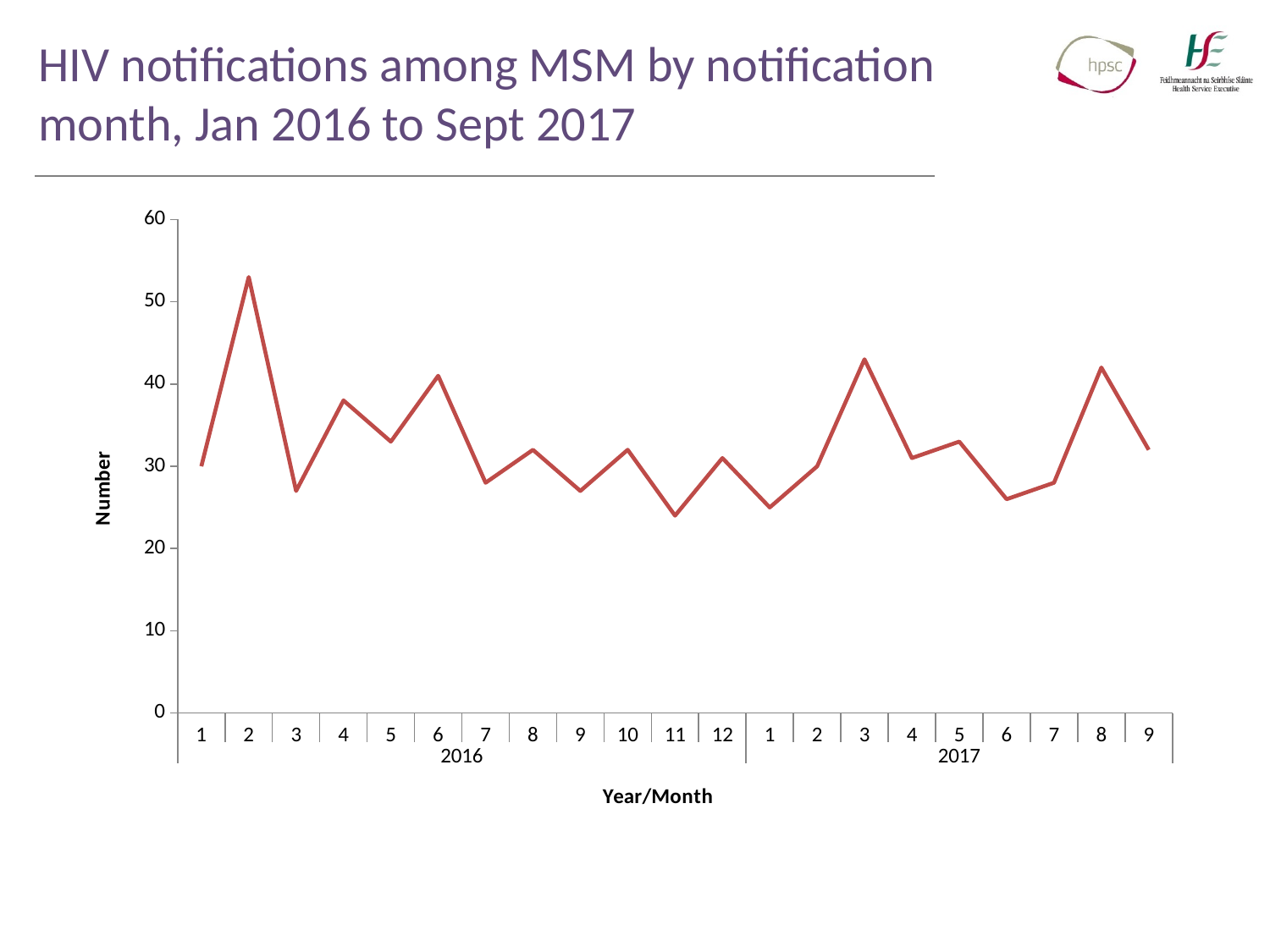
Is the value for month 11 of 2016 greater or less than 30? less Is the value for month 3 of 2017 greater or less than 40? greater Is the value for month 2 of 2016 greater or less than 50? greater What is the title of the vertical axis? Number What kind of chart is shown on the slide? line chart Which is larger, the value for month 6 of 2016 or the value for month 7 of 2016? Month 6 of 2016 Which month has the highest number of HIV notifications among MSM? Month 2 of 2016 Do the values rise or fall from month 1 to month 2 of 2016? rise How many monthly data points are plotted on the chart? 21 Which is larger, the value for month 2 of 2016 or the value for month 3 of 2017? Month 2 of 2016